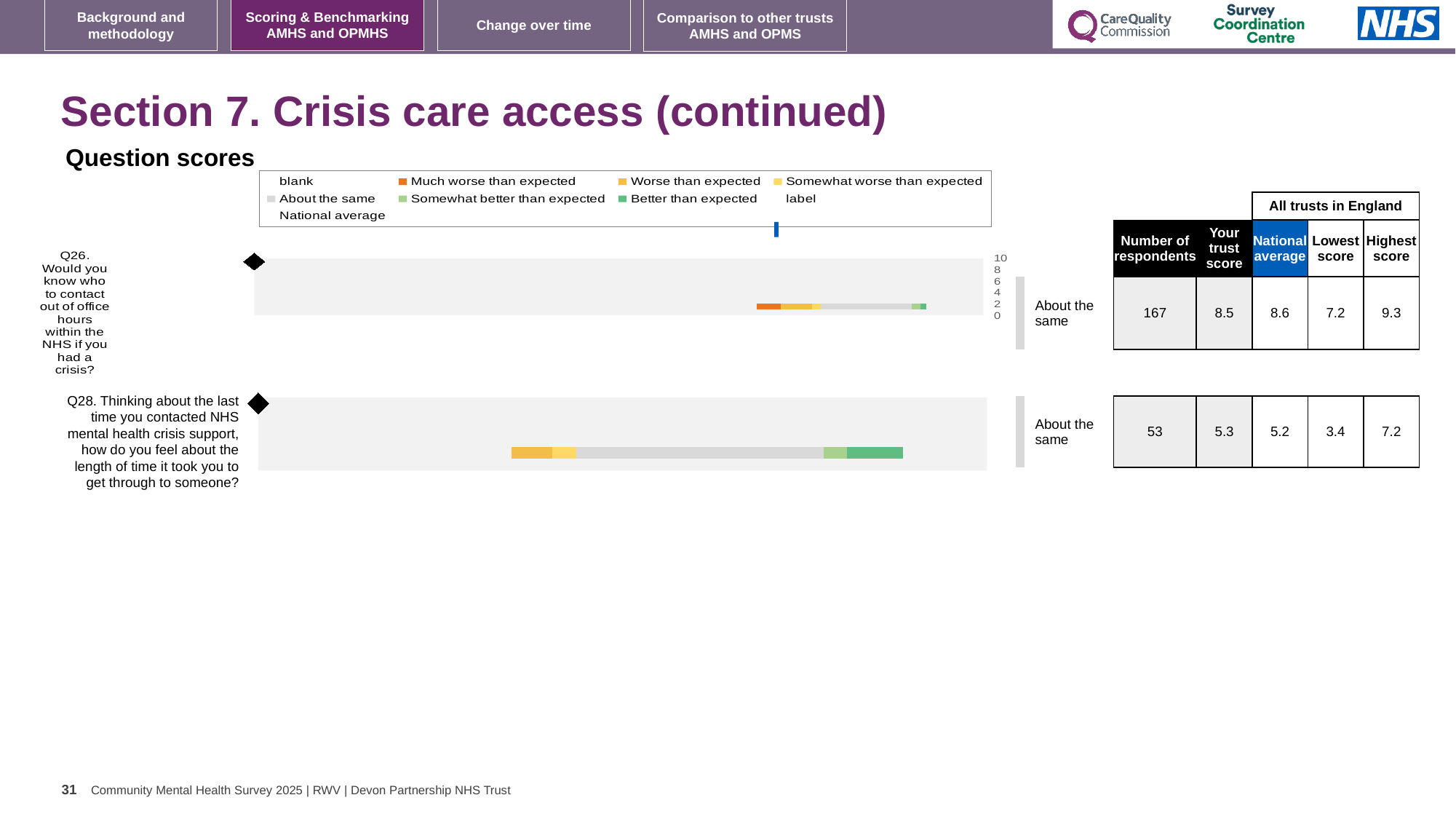
How many questions are plotted in the question scores charts? 2 What is the difference between the highest score and the lowest score shown for Q26? 2.1 In the legend, which colour represents 'Better than expected'? green What is the trust score shown for Q26 (knowing who to contact out of office hours in a crisis)? 8.5 What is the trust score shown for Q28 (length of time to get through to crisis support)? 5.3 What kind of chart is used to show the question scores for Q26 and Q28? bar chart What benchmark category is shown next to the Q26 chart? About the same How many respondents are shown for Q26? 167 Which question has the higher trust score, Q26 or Q28? Q26 What is the national average shown for Q28? 5.2 What is the highest score across all trusts in England shown for Q28? 7.2 In the legend, which colour represents 'Much worse than expected'? orange